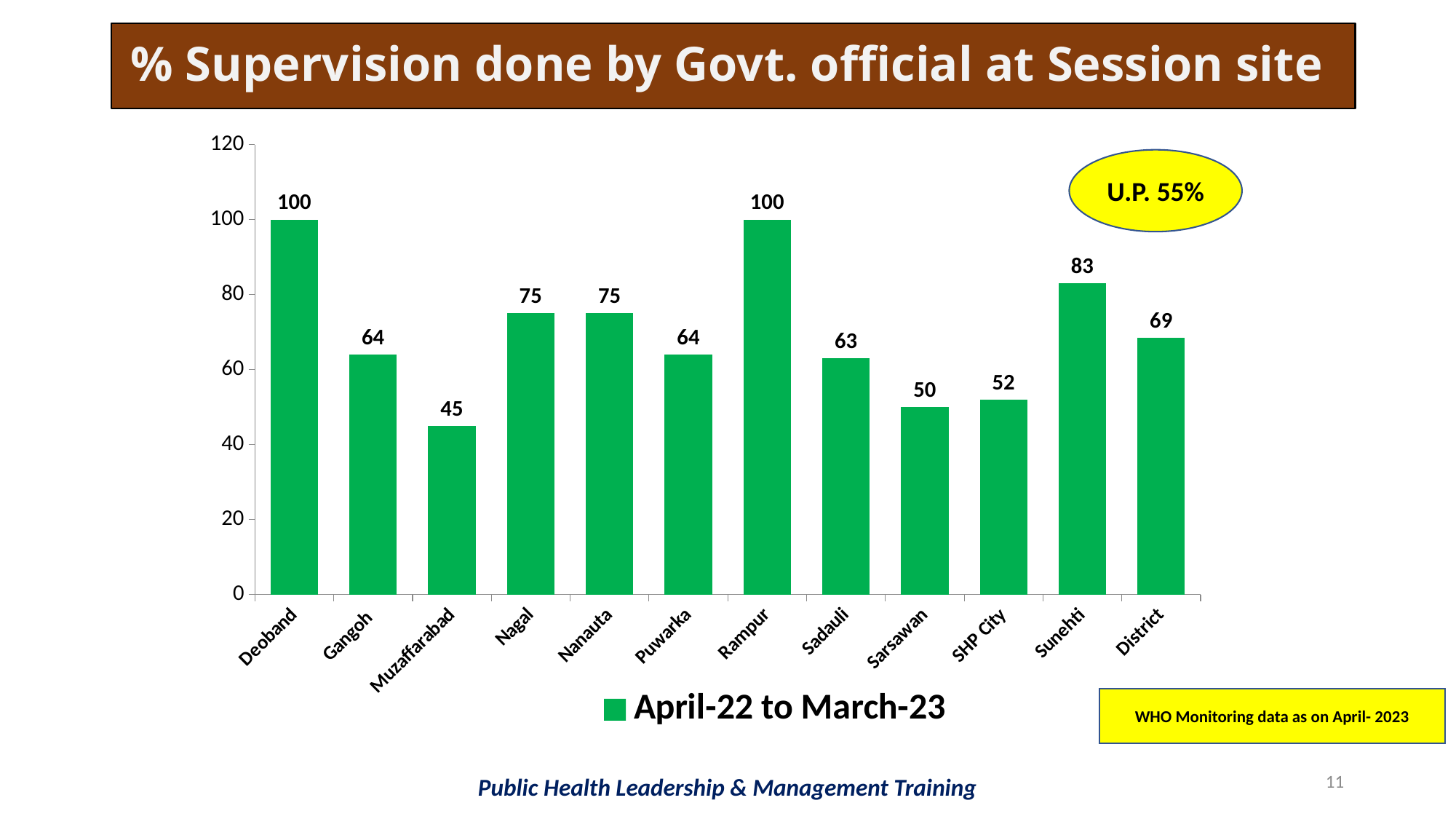
Which category has the lowest value? Muzaffarabad What is the value for Muzaffarabad? 45 Which categories share the highest value of 100? Deoband and Rampur What is the legend entry for the series? April-22 to March-23 How many categories are shown on the x axis? 12 What is the value for Sunehti? 83 Which is larger, the value for Sadauli or the value for SHP City? Sadauli How many series does the legend list? 1 What is the difference between the values for Sunehti and Sarsawan? 33 What kind of chart is shown? bar chart Is the value for Nagal greater or less than 60? greater What is the value for District? 69